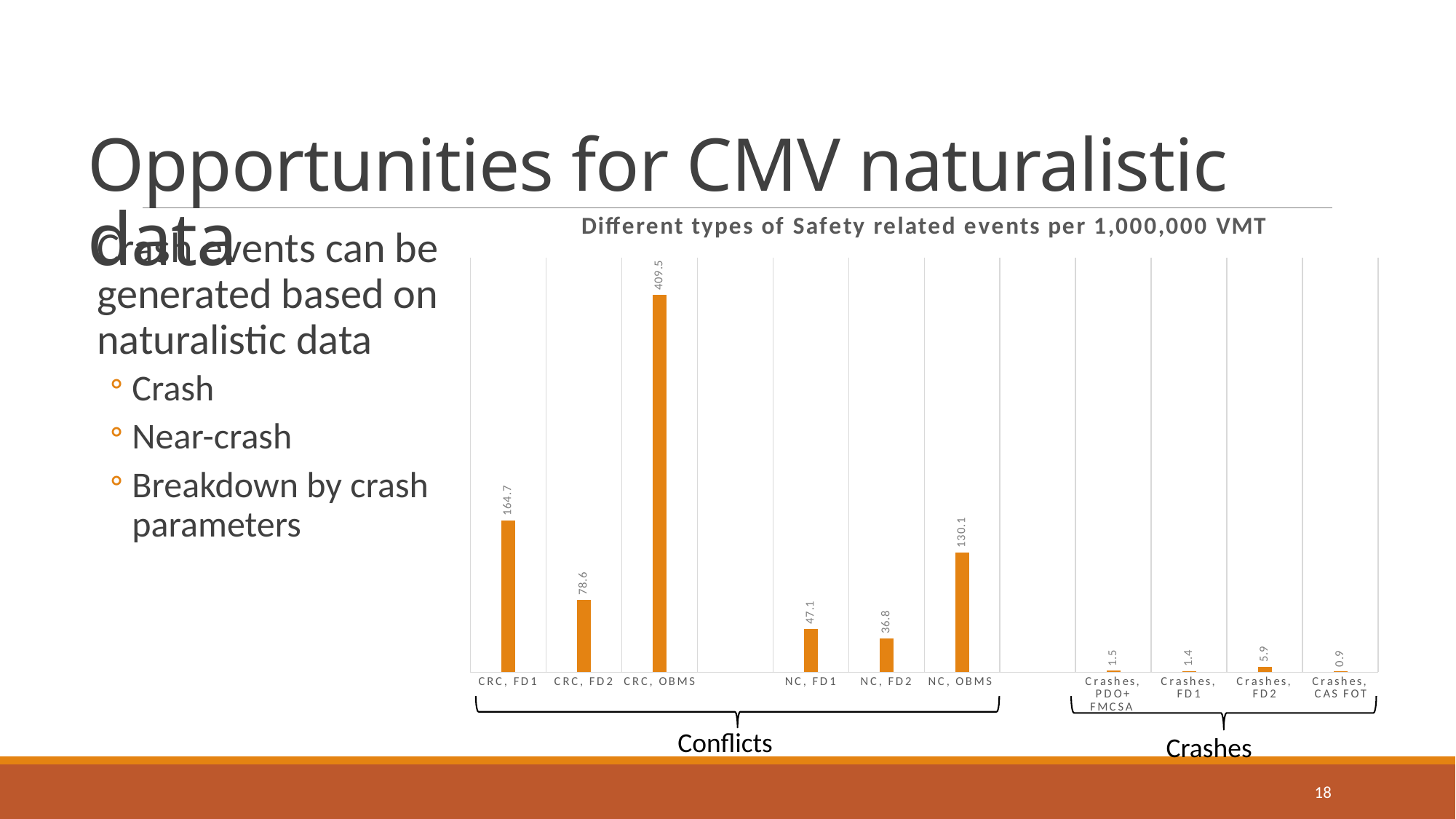
What is the value for NC, FD2? 36.8 What kind of chart is shown on the slide? Bar chart Which is larger, the value for CRC, FD2 or the value for NC, OBMS? NC, OBMS What is the title of the chart? Different types of Safety related events per 1,000,000 VMT What is the value for CRC, OBMS? 409.5 How many categories are plotted in the chart? 10 Which category has the highest value? CRC, OBMS Which category has the lowest value? Crashes, CAS FOT What is the difference between the values for CRC, FD1 and CRC, FD2? 86.1 What is the value for Crashes, FD2? 5.9 What is the difference between the values for NC, OBMS and NC, FD1? 83.0 What is the value for Crashes, CAS FOT? 0.9